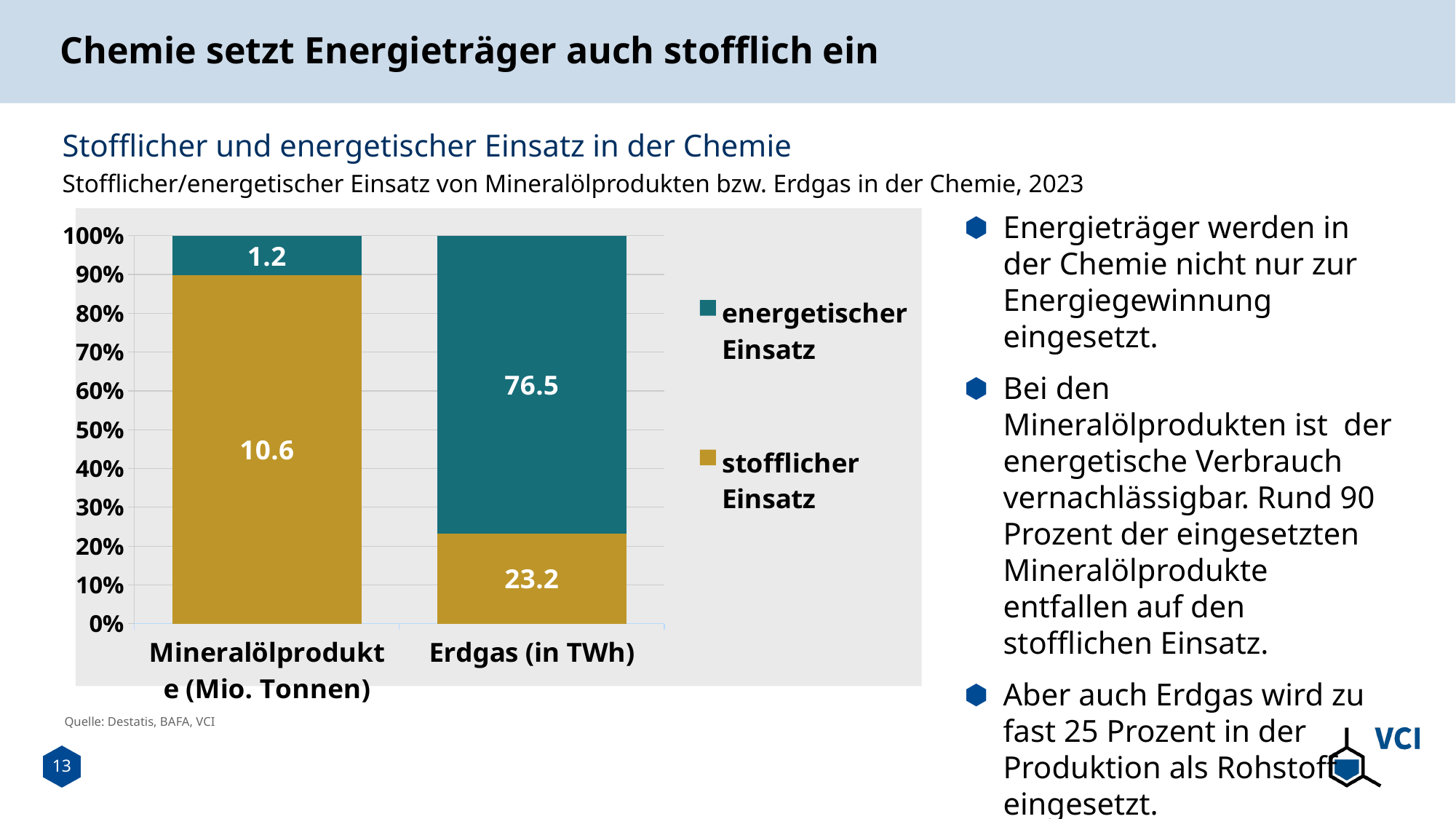
What is the value of stofflicher Einsatz for Erdgas (in TWh)? 23.2 Is the share of stofflicher Einsatz in the Erdgas (in TWh) bar greater or less than 30%? less What is the value of energetischer Einsatz for Erdgas (in TWh)? 76.5 What kind of chart is shown on the slide? stacked bar chart For Mineralölprodukte (Mio. Tonnen), which is larger: stofflicher Einsatz or energetischer Einsatz? stofflicher Einsatz What is the total of the two labelled values in the Mineralölprodukte (Mio. Tonnen) bar? 11.8 What is the difference between energetischer Einsatz and stofflicher Einsatz for Erdgas (in TWh)? 53.3 What is the value of energetischer Einsatz for Mineralölprodukte (Mio. Tonnen)? 1.2 How many series does the legend list? 2 What is the total of the two labelled values in the Erdgas (in TWh) bar? 99.7 What is the value of stofflicher Einsatz for Mineralölprodukte (Mio. Tonnen)? 10.6 For Erdgas (in TWh), which is larger: energetischer Einsatz or stofflicher Einsatz? energetischer Einsatz